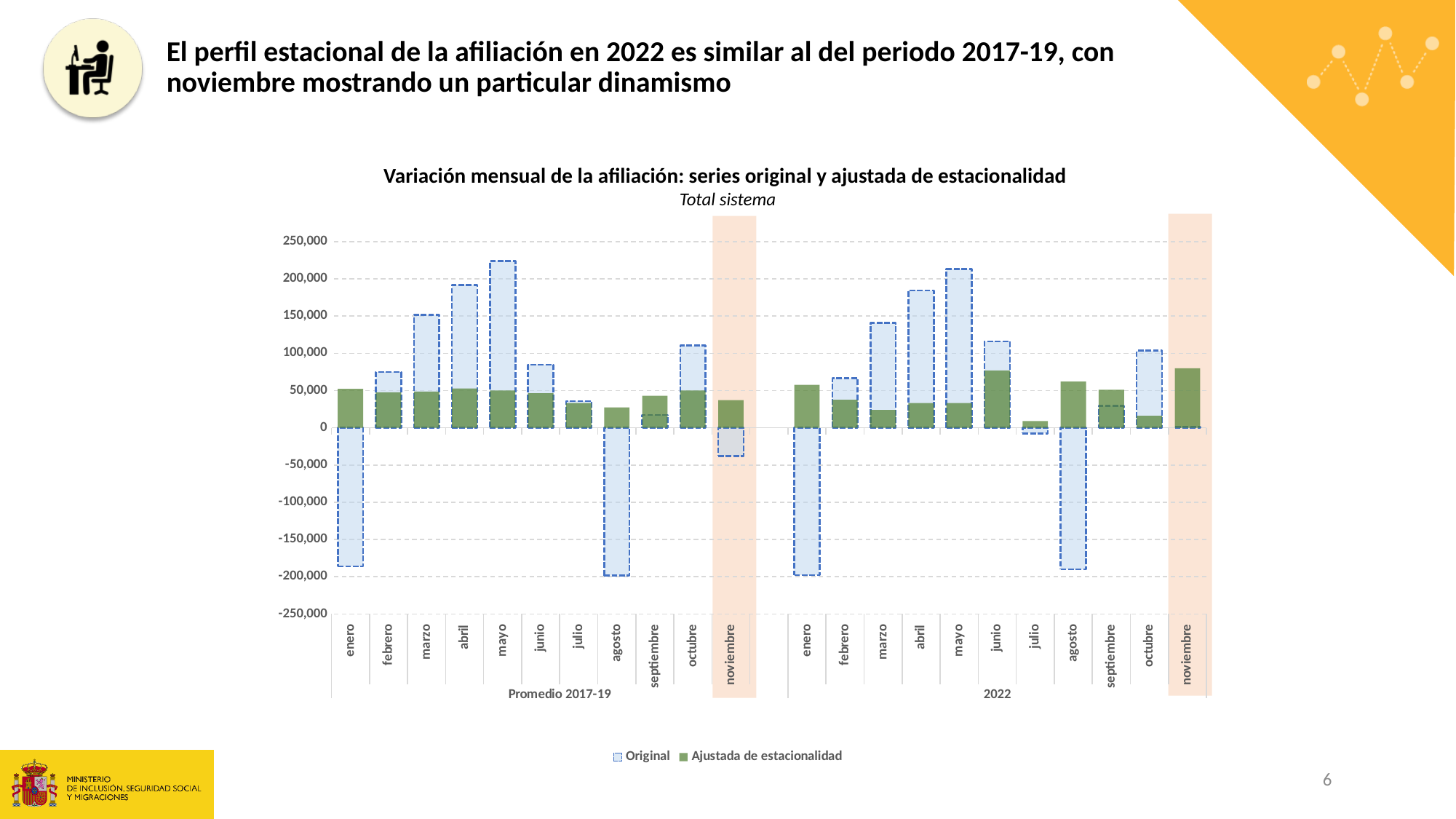
In the Promedio 2017-19 group, which month has the lowest Original value? agosto How many series does the chart legend list? 2 What is the title of the chart? Variación mensual de la afiliación: series original y ajustada de estacionalidad How many months are plotted in the 2022 group? 11 What are the two series named in the chart legend? Original and Ajustada de estacionalidad Is the Ajustada de estacionalidad value for noviembre 2022 greater or less than 50,000? greater Which is larger: the Ajustada de estacionalidad value for noviembre in 2022 or for noviembre in Promedio 2017-19? noviembre 2022 In the Promedio 2017-19 group, which month has the highest Original value? mayo Is the Original value for agosto 2022 greater or less than -150,000? less What kind of chart is shown on the slide? bar chart In the 2022 group, which month has the lowest Ajustada de estacionalidad value? julio Is the Original value for mayo 2022 greater or less than 200,000? greater